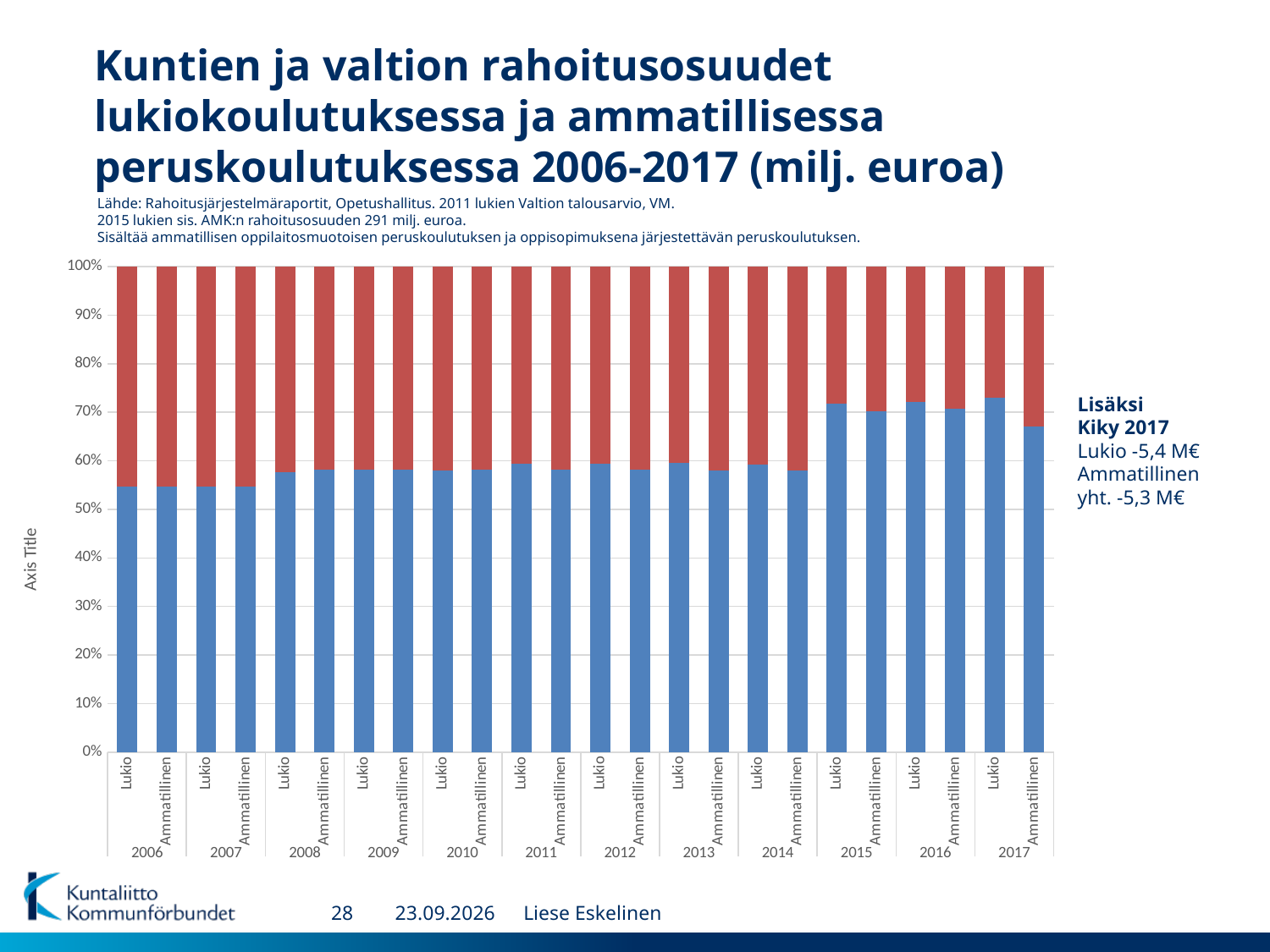
Is the blue portion of the Lukio bar for 2017 greater or less than 70%? greater What kind of chart is shown on the slide? Stacked bar chart Is the blue portion of the Ammatillinen bar for 2010 greater or less than 60%? less Which has the larger blue portion in 2017, the Lukio bar or the Ammatillinen bar? Lukio Is the blue portion of the Ammatillinen bar for 2017 greater or less than 70%? less What is the total height of each stacked bar in the chart? 100% How many years are shown along the x axis of the chart? 12 Does the blue share of the Lukio bars rise or fall from 2006 to 2017? rise How many bars are plotted in the chart? 24 What is the label shown on the vertical axis of the chart? Axis Title Which has the larger blue portion, the Lukio bar for 2006 or the Lukio bar for 2015? Lukio 2015